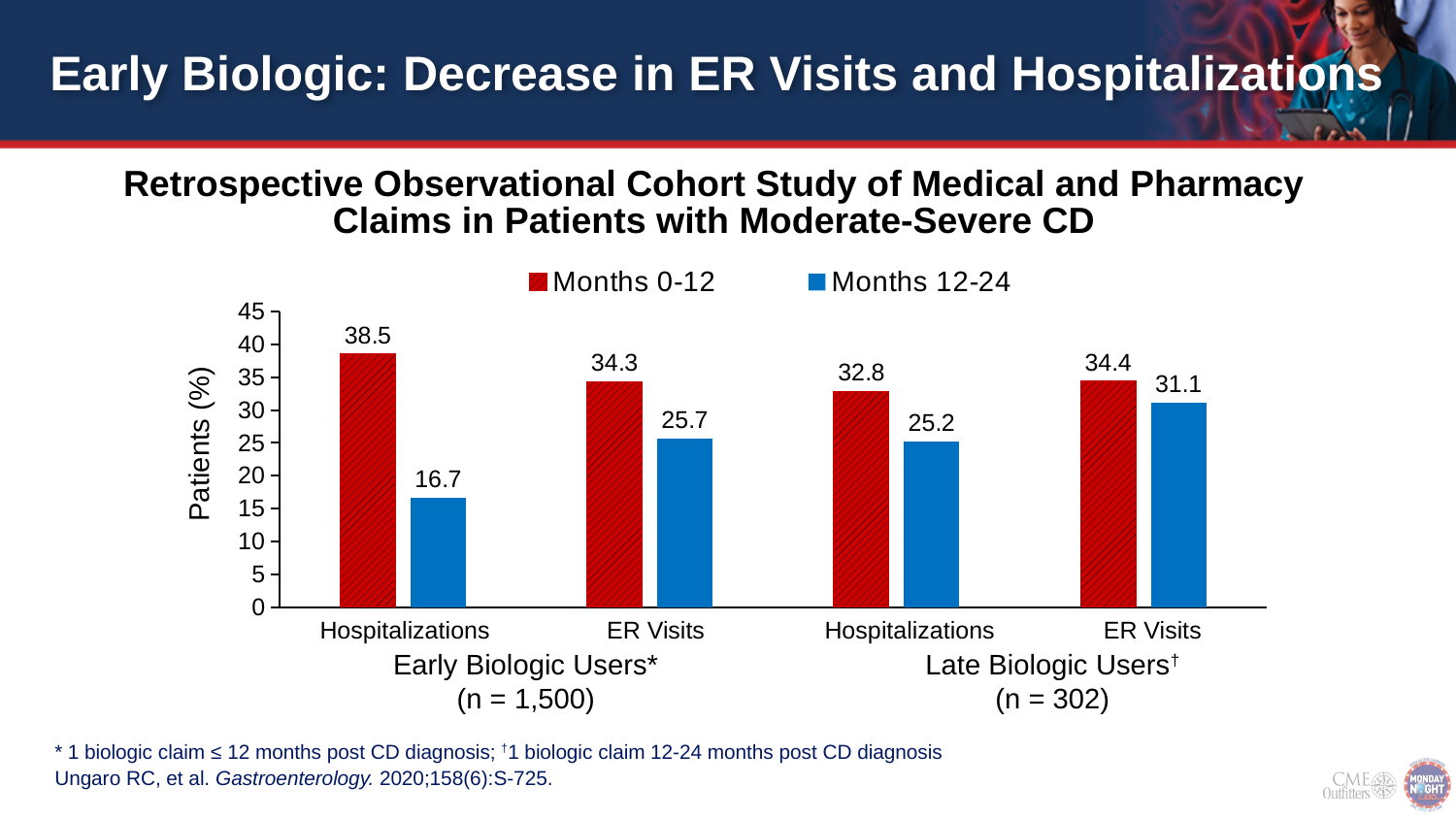
What kind of chart is shown on the slide? Bar chart What is the Months 0-12 value for Hospitalizations among Early Biologic Users? 38.5 What is the difference between the Months 0-12 and Months 12-24 values for ER Visits among Late Biologic Users? 3.3 What is the Months 0-12 value for Hospitalizations among Late Biologic Users? 32.8 Which bar has the highest value on the chart? Months 0-12, Hospitalizations, Early Biologic Users (38.5) What is the label of the y axis? Patients (%) Which bar has the lowest value on the chart? Months 12-24, Hospitalizations, Early Biologic Users (16.7) Which is larger: the Months 12-24 value for ER Visits among Early Biologic Users or among Late Biologic Users? Late Biologic Users (31.1) What is the Months 12-24 value for ER Visits among Late Biologic Users? 31.1 What is the difference between the Months 0-12 and Months 12-24 values for Hospitalizations among Early Biologic Users? 21.8 What is the Months 12-24 value for Hospitalizations among Early Biologic Users? 16.7 How many series does the legend list? 2